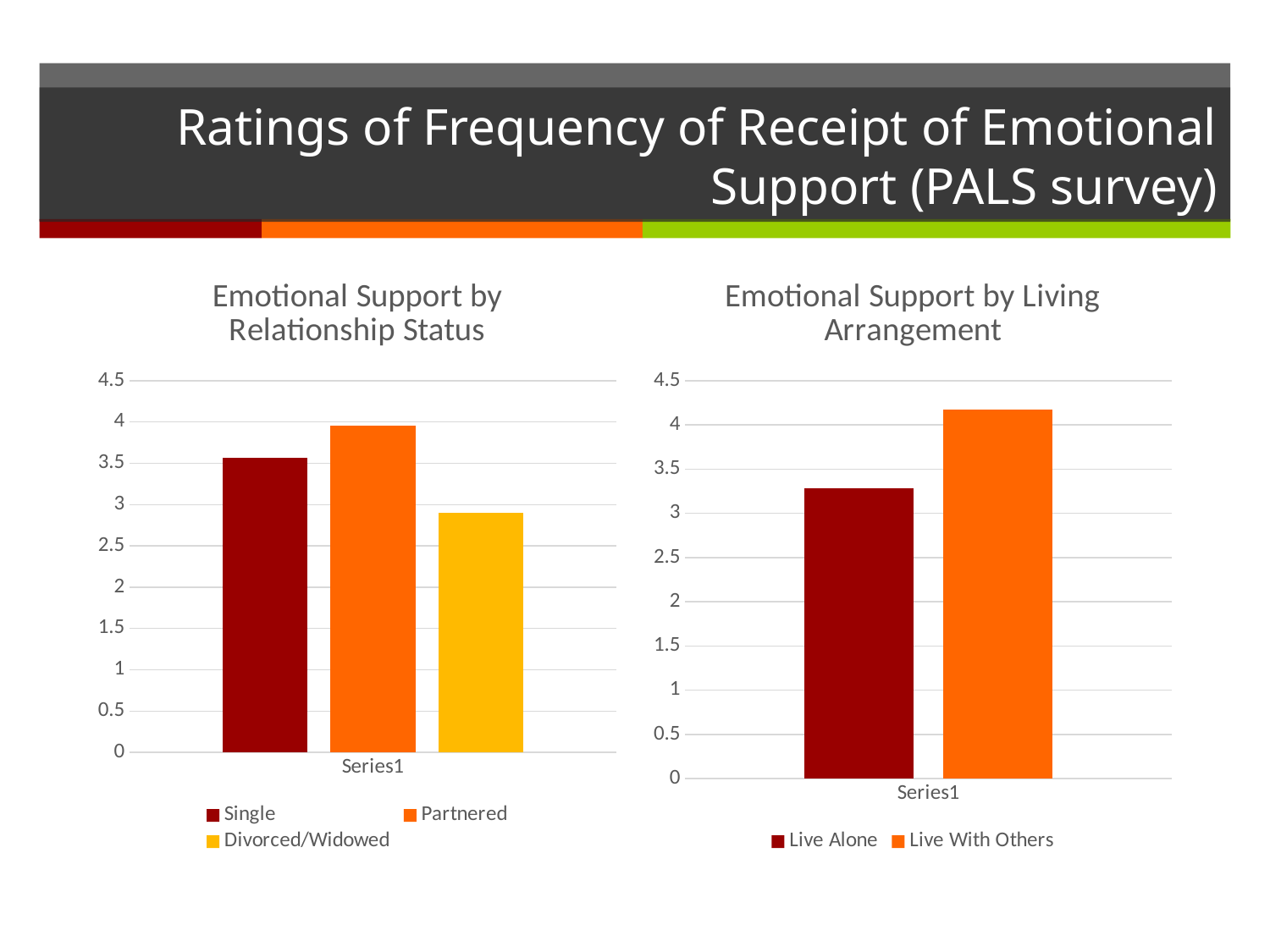
In the 'Emotional Support by Relationship Status' chart, is the value for Single greater or less than 3? greater In the 'Emotional Support by Living Arrangement' chart, which category has the higher value? Live With Others In the 'Emotional Support by Relationship Status' chart, is the value for Partnered greater or less than 3.5? greater In the 'Emotional Support by Relationship Status' chart, which category has the lowest value? Divorced/Widowed In the 'Emotional Support by Living Arrangement' chart, how many series does the legend list? 2 In the 'Emotional Support by Living Arrangement' chart, is the value for Live Alone greater or less than 3.5? less In the 'Emotional Support by Relationship Status' chart, how many series does the legend list? 3 In the 'Emotional Support by Relationship Status' chart, which category has the highest value? Partnered What kind of chart is the 'Emotional Support by Living Arrangement' chart? Bar chart In the 'Emotional Support by Relationship Status' chart, what colour is the Divorced/Widowed bar? Yellow